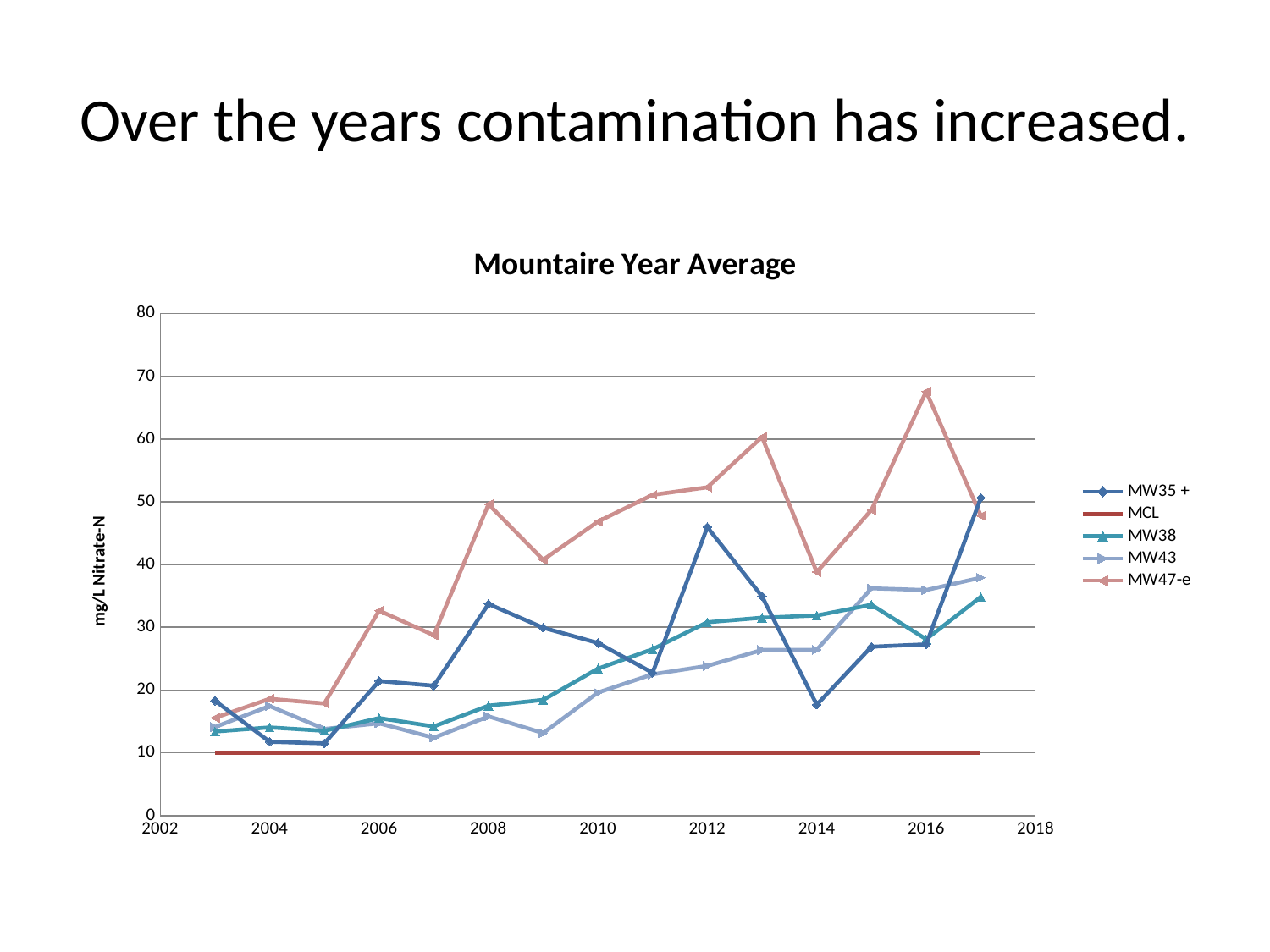
Does the MW47-e series generally rise or fall from 2003 to 2017? rise Is the value for MW35 + in 2014 greater or less than 20? less Is the value for MW35 + in 2012 greater or less than 40? greater What is the label on the vertical axis of the chart? mg/L Nitrate-N Which series reaches the highest value on the chart? MW47-e In 2012, which is larger: the value for MW35 + or the value for MW38? MW35 + What constant value does the MCL line sit at? 10 How many series does the chart's legend list? 5 Is the value for MW47-e in 2016 greater or less than 60? greater Which series stays lowest across the whole chart? MCL What kind of chart is shown on the slide? line chart What is the title of the chart? Mountaire Year Average